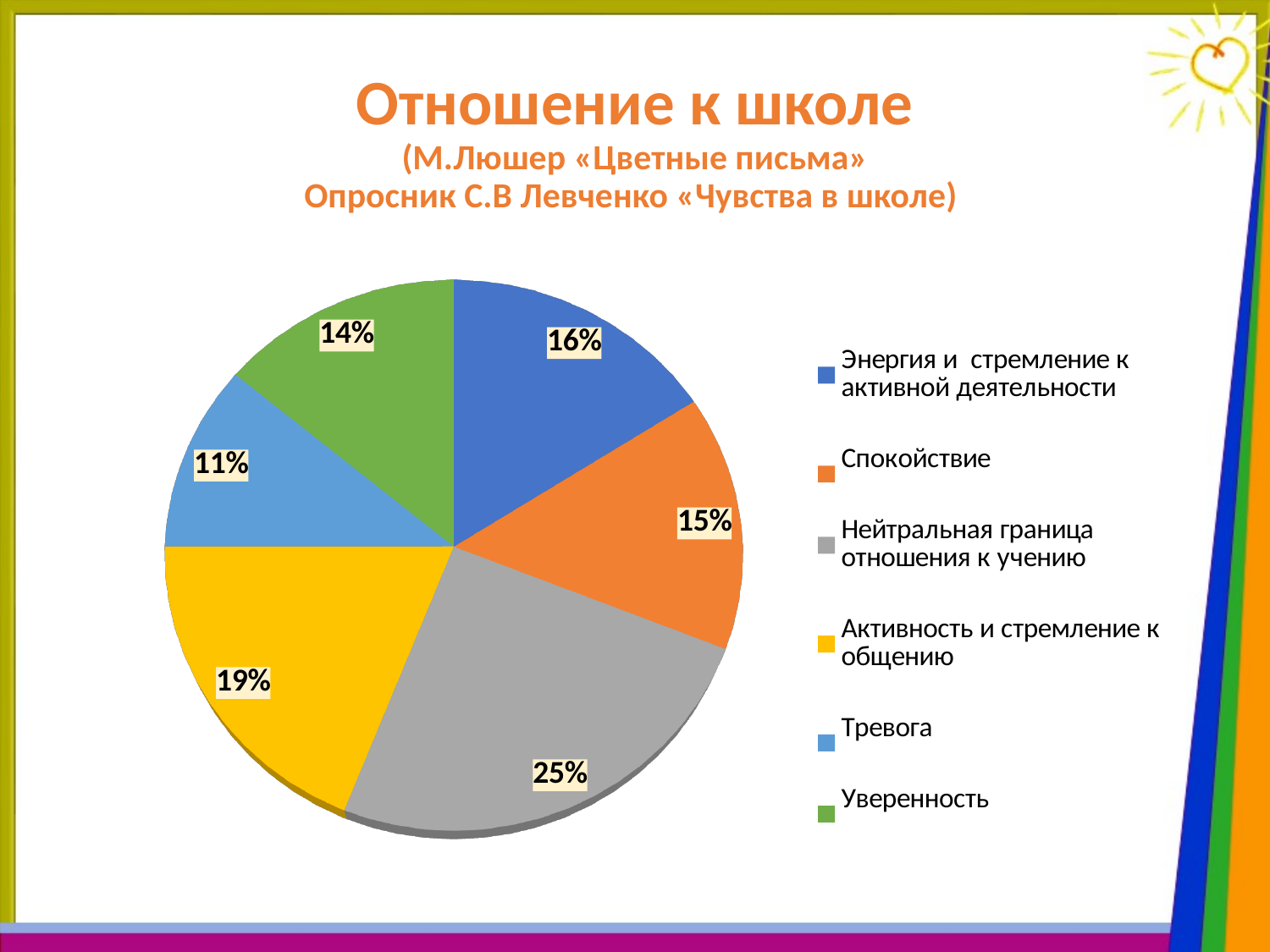
Which category has the largest slice of the pie? Нейтральная граница отношения к учению What colour is the slice for "Активность и стремление к общению"? Yellow What is the difference between the values for "Нейтральная граница отношения к учению" and "Тревога"? 14% What is the value for "Тревога"? 11% What is the value for "Активность и стремление к общению"? 19% What is the value for "Спокойствие"? 15% Which is larger: the value for "Энергия и стремление к активной деятельности" or the value for "Уверенность"? Энергия и стремление к активной деятельности What kind of chart is shown on the slide? Pie chart How many categories does the pie chart have? 6 What share of the pie does "Нейтральная граница отношения к учению" have? 25% Which category has the smallest slice of the pie? Тревога What is the value for "Уверенность"? 14%